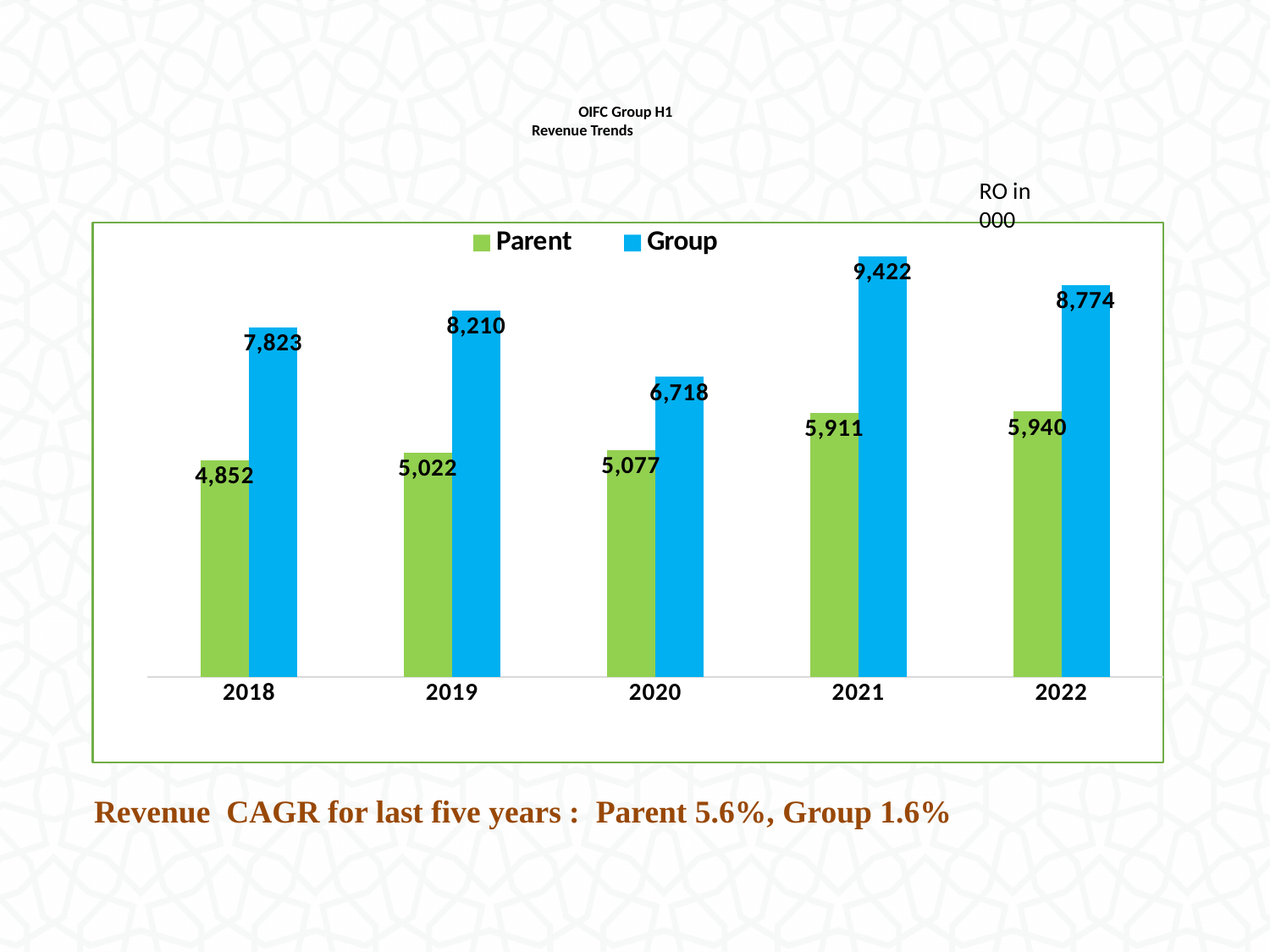
How many series does the legend list? 2 What is the Group revenue value for 2021? 9,422 In which year is the Parent revenue lowest? 2018 What kind of chart is shown on the slide? Bar chart What colour are the Group bars? Blue Does the Parent revenue rise or fall from 2018 to 2022? Rise Which is larger, the Group value for 2019 or the Group value for 2022? Group value for 2022 In which year is the Group revenue highest? 2021 What is the Group revenue value for 2020? 6,718 What is the difference between the Group and Parent values in 2022? 2,834 What is the Parent revenue value for 2018? 4,852 How many years are shown on the x axis? 5